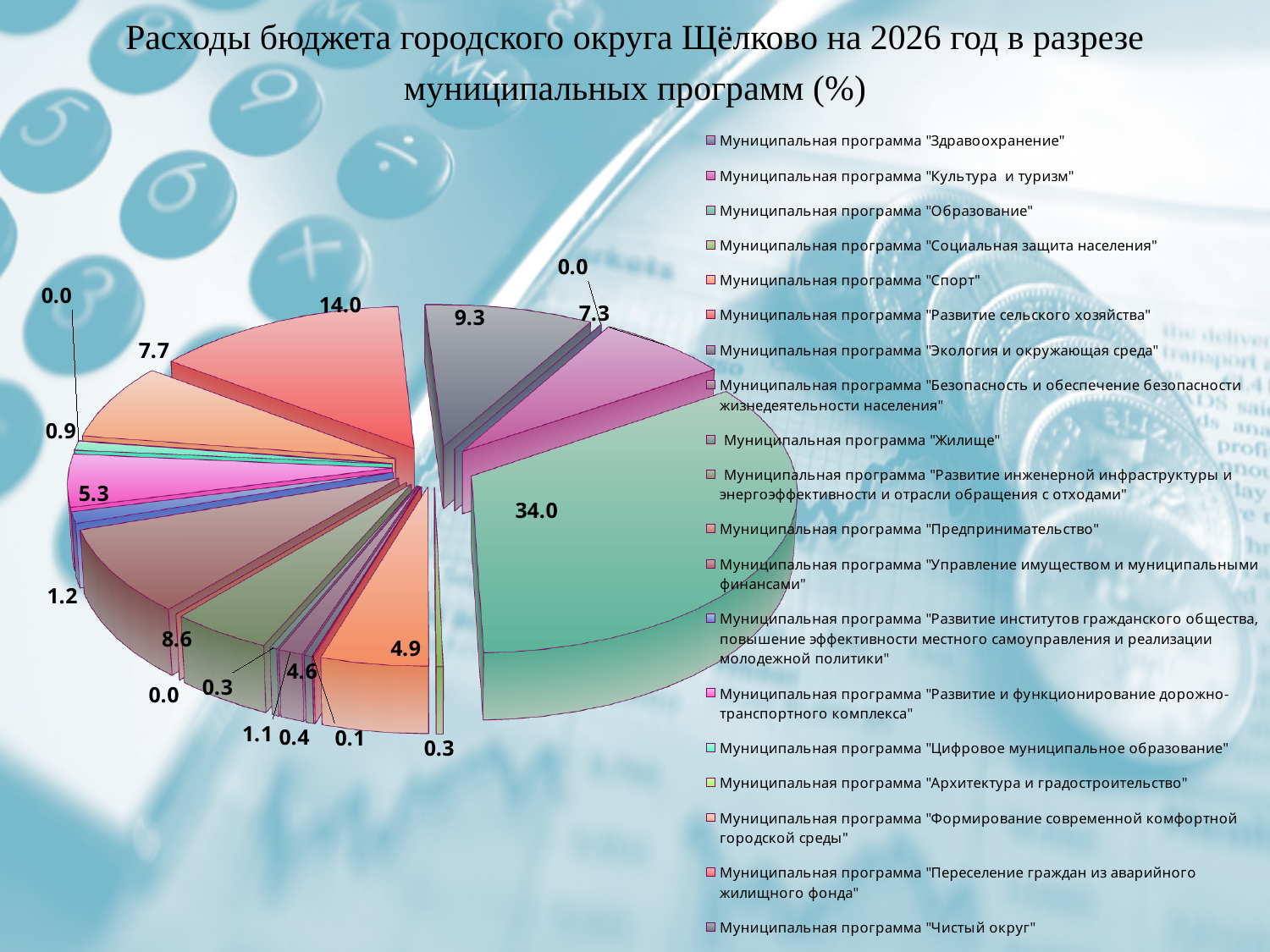
What is the difference between the largest slice (34.0) and the slice labelled 14.0? 20.0 What is the value of the second-largest slice in the pie chart? 14.0 Where is the legend placed relative to the pie chart? to the right What is the difference between the slices labelled 14.0 and 9.3? 4.7 What is the difference between the slices labelled 8.6 and 7.7? 0.9 What share of the budget does the largest slice of the pie represent? 34.0% How many slices in the pie chart are labelled 0.0? 3 Which is larger, the slice labelled 9.3 or the slice labelled 7.3? 9.3 What is the value of the largest slice in the pie chart? 34.0 What kind of chart is shown on the slide? pie chart What is the title of the chart on the slide? Расходы бюджета городского округа Щёлково на 2026 год в разрезе муниципальных программ (%) How many municipal programmes does the legend of the pie chart list? 19